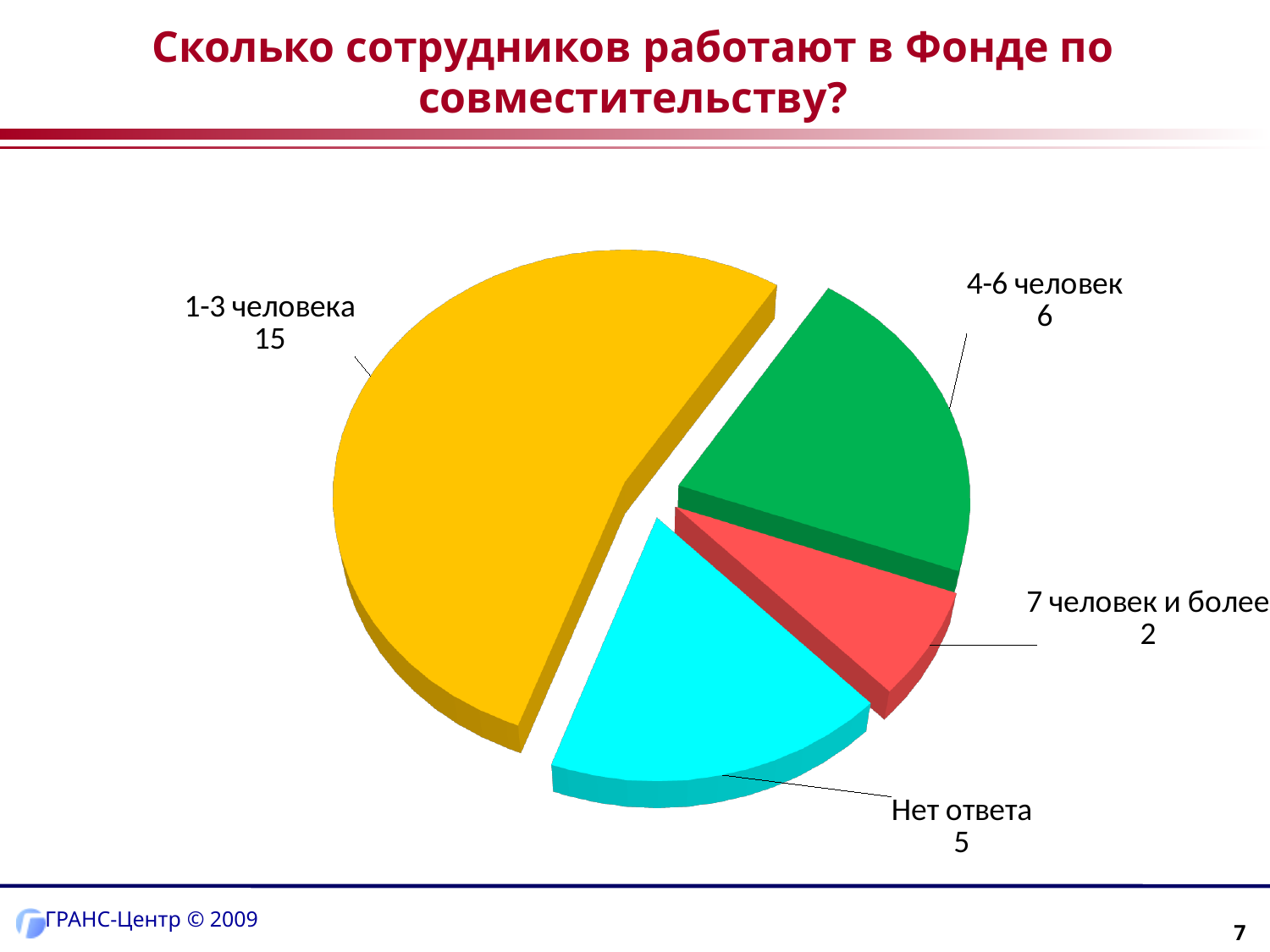
What is the title of the chart on the slide? Сколько сотрудников работают в Фонде по совместительству? Which category has the largest slice? 1-3 человека Which is larger, the value for "4-6 человек" or the value for "Нет ответа"? 4-6 человек What is the difference between the values for "1-3 человека" and "4-6 человек"? 9 What is the value for the "Нет ответа" slice? 5 What type of chart is shown on the slide? Pie chart What is the total of all slices in the pie chart? 28 What is the value for the "4-6 человек" slice? 6 How many slices does the pie chart have? 4 What is the value for the "1-3 человека" slice? 15 What is the value for the "7 человек и более" slice? 2 Which category has the smallest slice? 7 человек и более